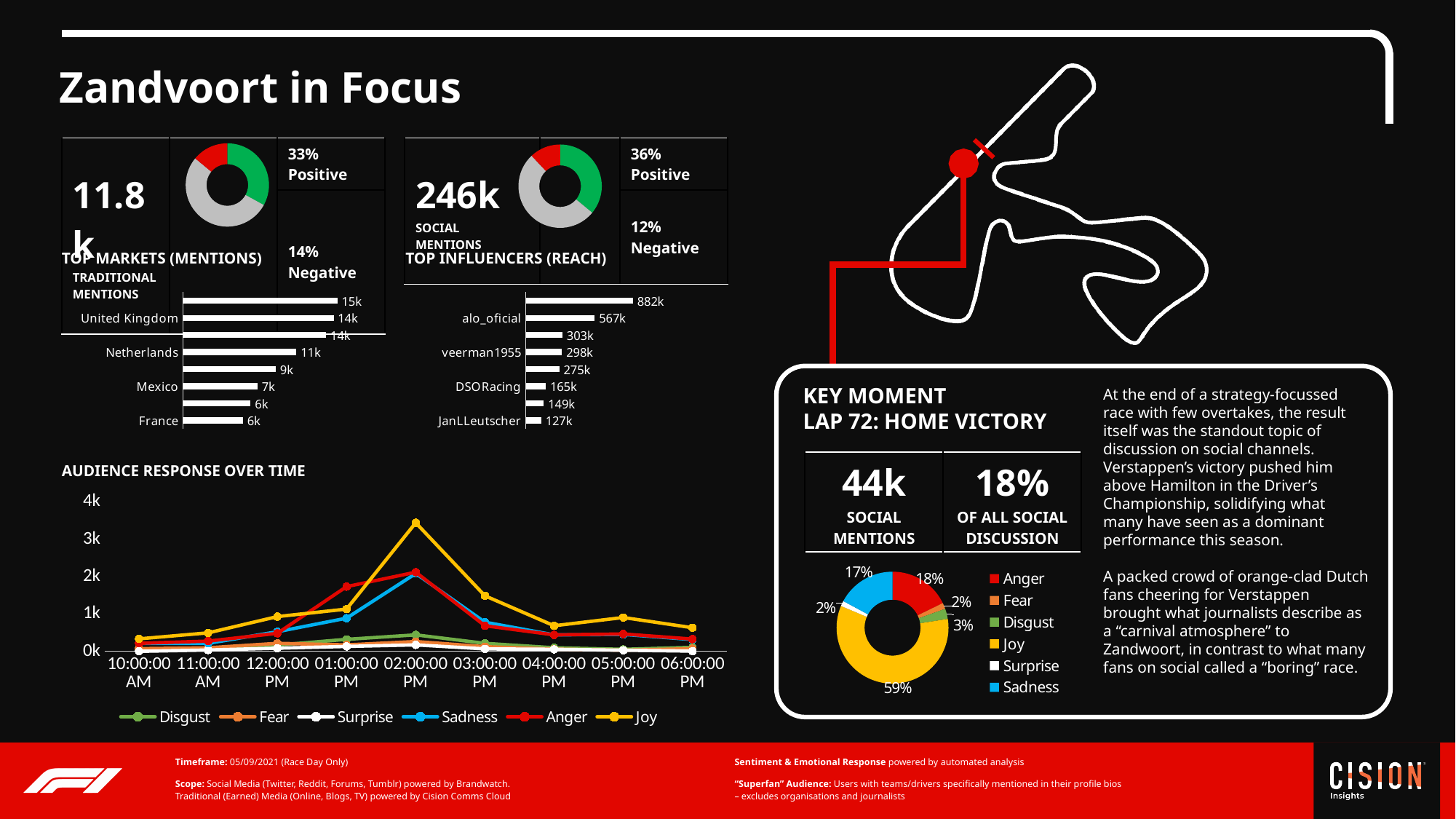
In the Top Influencers (Reach) chart, which has the larger reach, veerman1955 or DSORacing? veerman1955 In the Top Markets (Mentions) chart, what is the value for France? 6k In the Audience Response Over Time chart, which series has the highest value at 02:00:00 PM? Joy In the Top Influencers (Reach) chart, what is the reach of alo_oficial? 567k In the Key Moment donut chart, what is the difference between the Anger and Sadness shares? 1% How many series does the legend of the Audience Response Over Time chart list? 6 In the Key Moment donut chart, what share does Joy have? 59% What kind of chart is the Audience Response Over Time chart? Line chart In the Top Markets (Mentions) chart, how many mentions does the United Kingdom have? 14k In the Audience Response Over Time chart, is the value for Joy at 02:00:00 PM greater or less than 3k? greater In the Top Markets (Mentions) chart, what is the difference between the Netherlands and Mexico? 4k In the Top Influencers (Reach) chart, what is the reach of JanLLeutscher? 127k